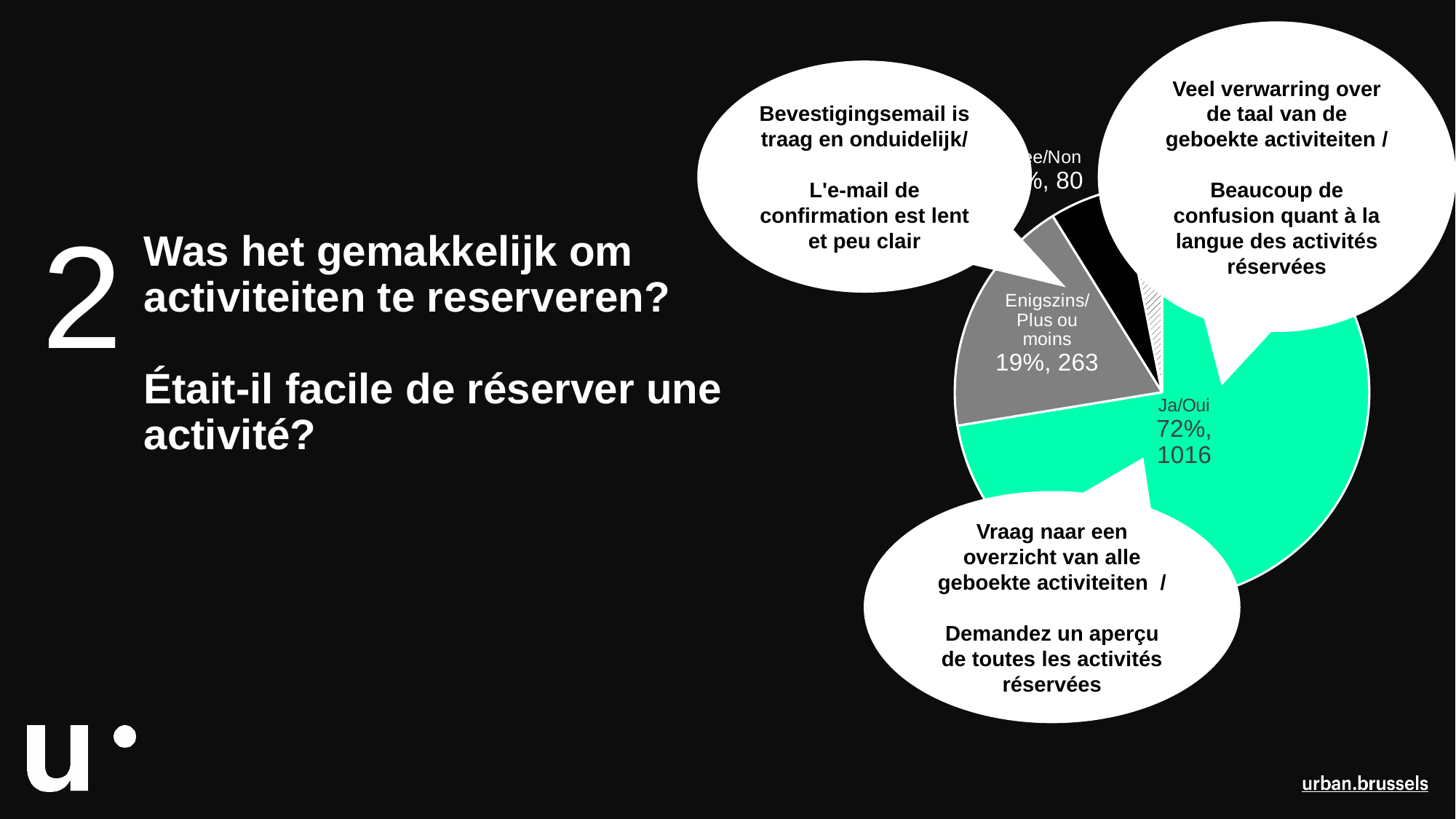
Which slice of the pie chart is the largest? Ja/Oui What percentage is shown for the Enigszins/Plus ou moins slice? 19% How many responses does the Ja/Oui slice represent? 1016 What percentage is shown for the Ja/Oui slice? 72% What kind of chart is shown on the slide? pie chart What colour is the Enigszins/Plus ou moins slice of the pie chart? grey Which is larger, the Ja/Oui slice or the Enigszins/Plus ou moins slice? Ja/Oui What colour is the Ja/Oui slice of the pie chart? green How many responses does the Enigszins/Plus ou moins slice represent? 263 By how many percentage points does the Ja/Oui share exceed the Enigszins/Plus ou moins share? 53 percentage points What is the difference in number of responses between Ja/Oui and Enigszins/Plus ou moins? 753 How many responses does the Nee/Non slice represent? 80